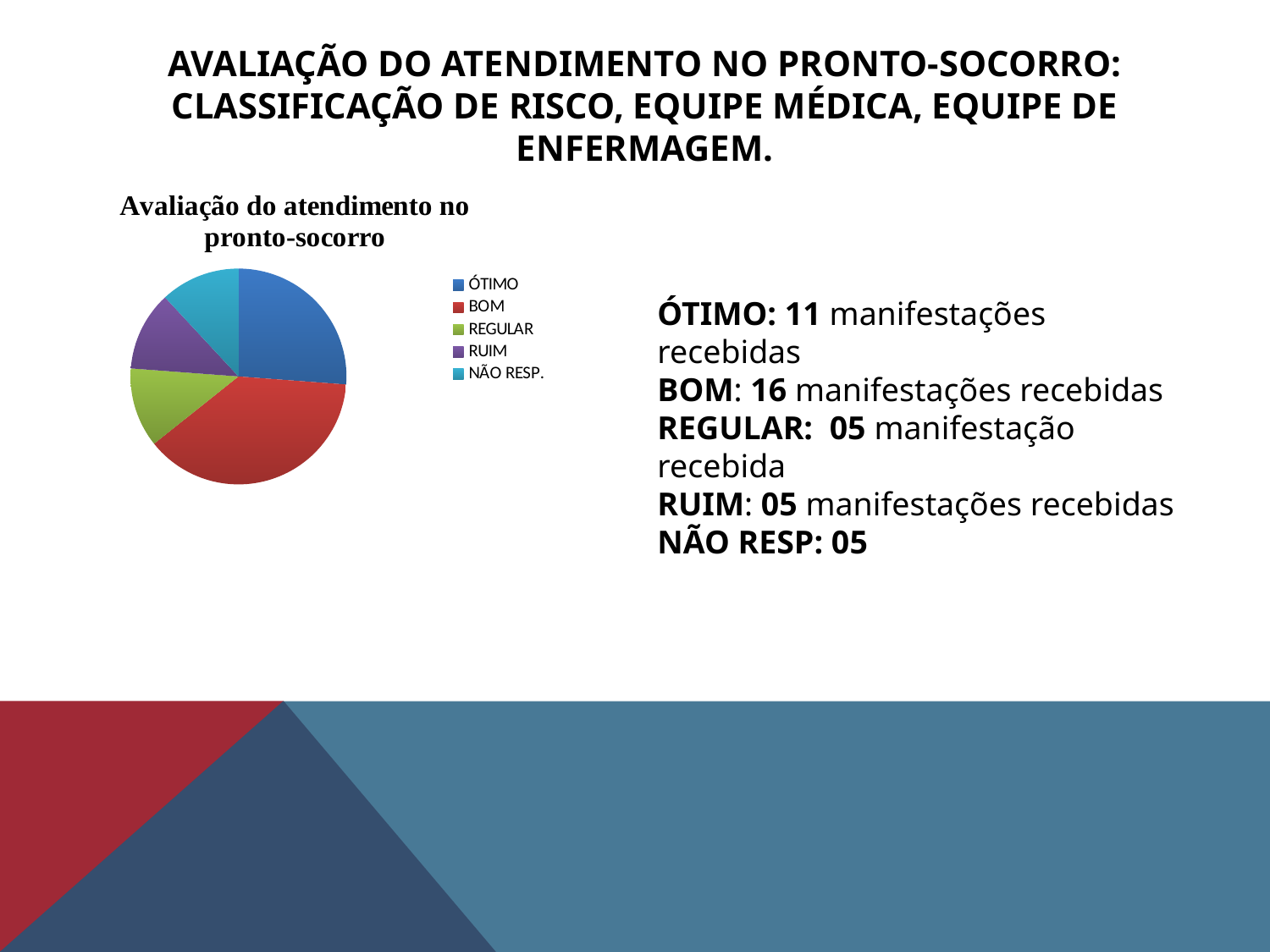
How many manifestações were received for BOM? 16 What is the difference between the number of manifestações for BOM and for ÓTIMO? 5 How many entries does the chart legend list? 5 How many manifestações were received for REGULAR? 05 Which category has the largest slice of the pie? BOM What colour represents BOM in the pie chart? red Which is larger, the slice for ÓTIMO or the slice for BOM? BOM How many categories does the pie chart have? 5 What is the title of the chart? Avaliação do atendimento no pronto-socorro What kind of chart is shown on the slide? pie chart What is the value for NÃO RESP? 05 How many manifestações were received for ÓTIMO? 11